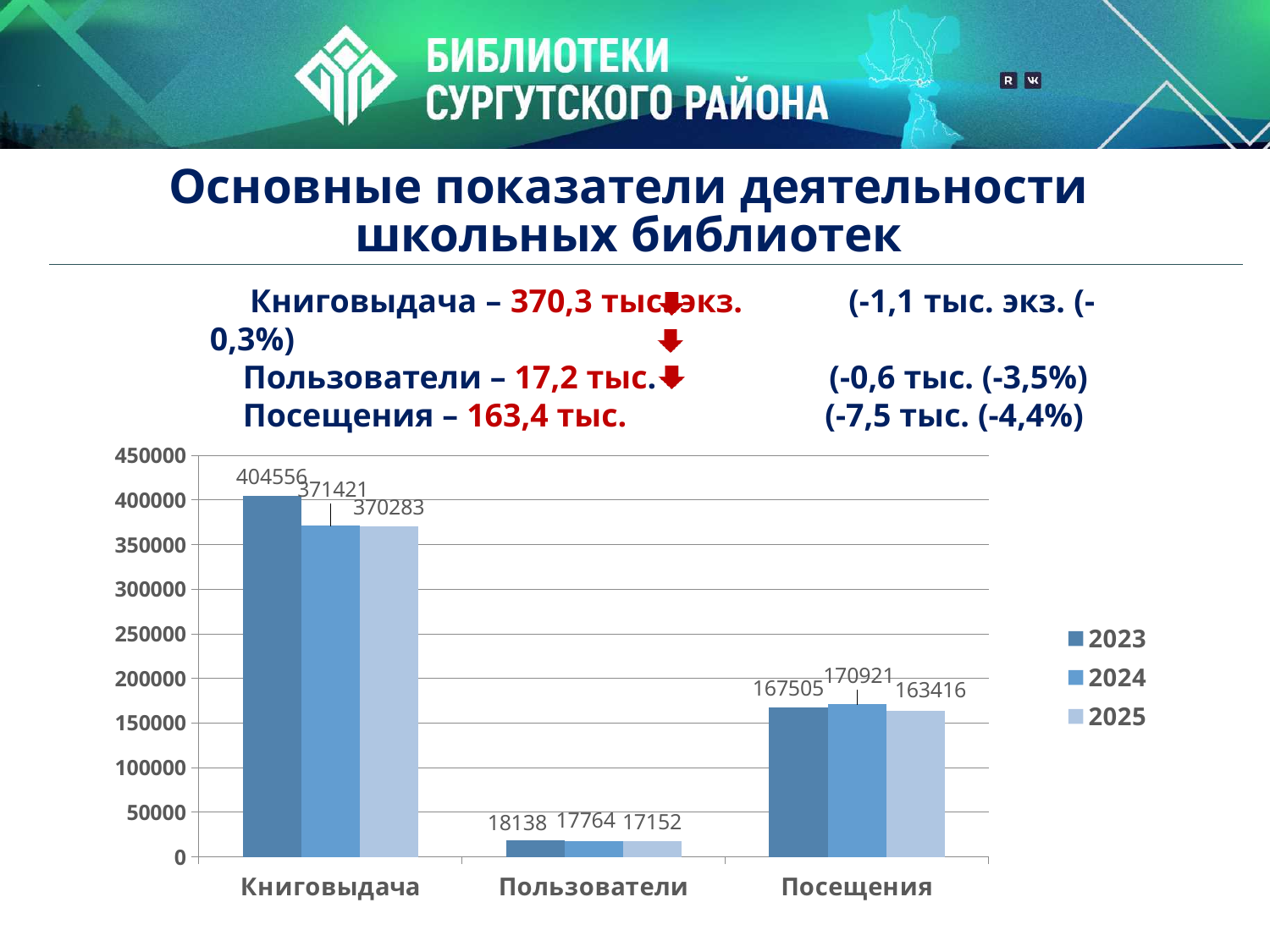
How many series does the legend list? 3 Which category has the lowest value in 2023? Пользователи What is the difference between the 2023 and 2025 values for Книговыдача? 34273 Which category has the highest value in 2025? Книговыдача What is the difference between the 2024 and 2025 values for Посещения? 7505 What is the value for Посещения in 2024? 170921 What is the value for Книговыдача in 2023? 404556 What is the value for Пользователи in 2025? 17152 How many categories are shown on the x axis? 3 Which is larger for Посещения: the 2023 value or the 2024 value? 2024 Is the value for Книговыдача in 2024 greater or less than 400000? less What kind of chart is shown on the slide? bar chart